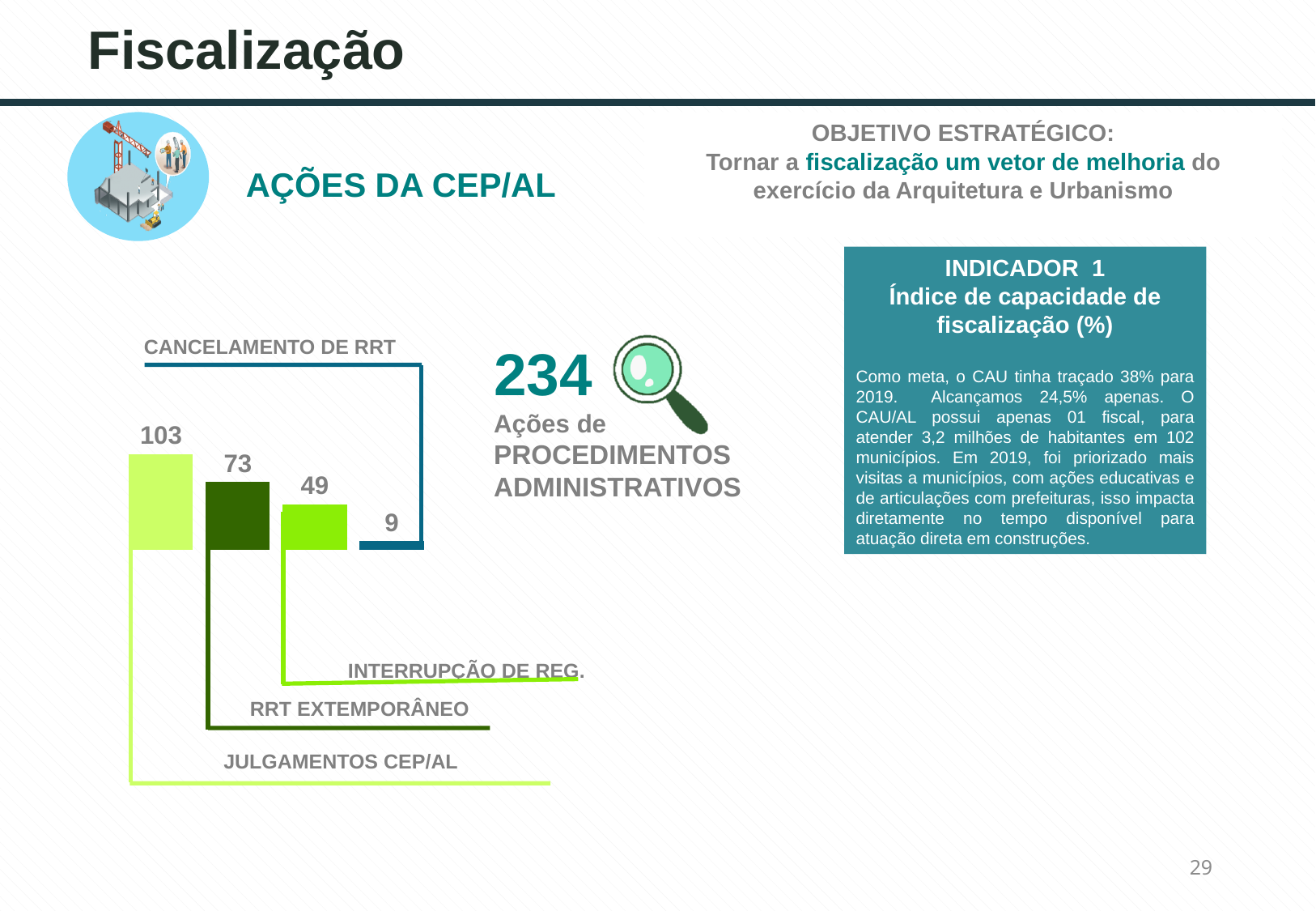
What is the value for INTERRUPÇÃO DE REG. in the bar chart? 49 What is the total number of administrative procedure actions shown next to the chart? 234 Which is larger, the value for RRT EXTEMPORÂNEO or the value for INTERRUPÇÃO DE REG.? RRT EXTEMPORÂNEO Which category has the highest value in the bar chart? JULGAMENTOS CEP/AL What is the difference between the values for JULGAMENTOS CEP/AL and RRT EXTEMPORÂNEO? 30 What kind of chart is shown on the slide? bar chart What is the value for RRT EXTEMPORÂNEO in the bar chart? 73 What is the value for JULGAMENTOS CEP/AL in the bar chart? 103 What is the difference between the values for INTERRUPÇÃO DE REG. and CANCELAMENTO DE RRT? 40 Which category has the lowest value in the bar chart? CANCELAMENTO DE RRT What is the value for CANCELAMENTO DE RRT in the bar chart? 9 How many categories are shown in the bar chart? 4